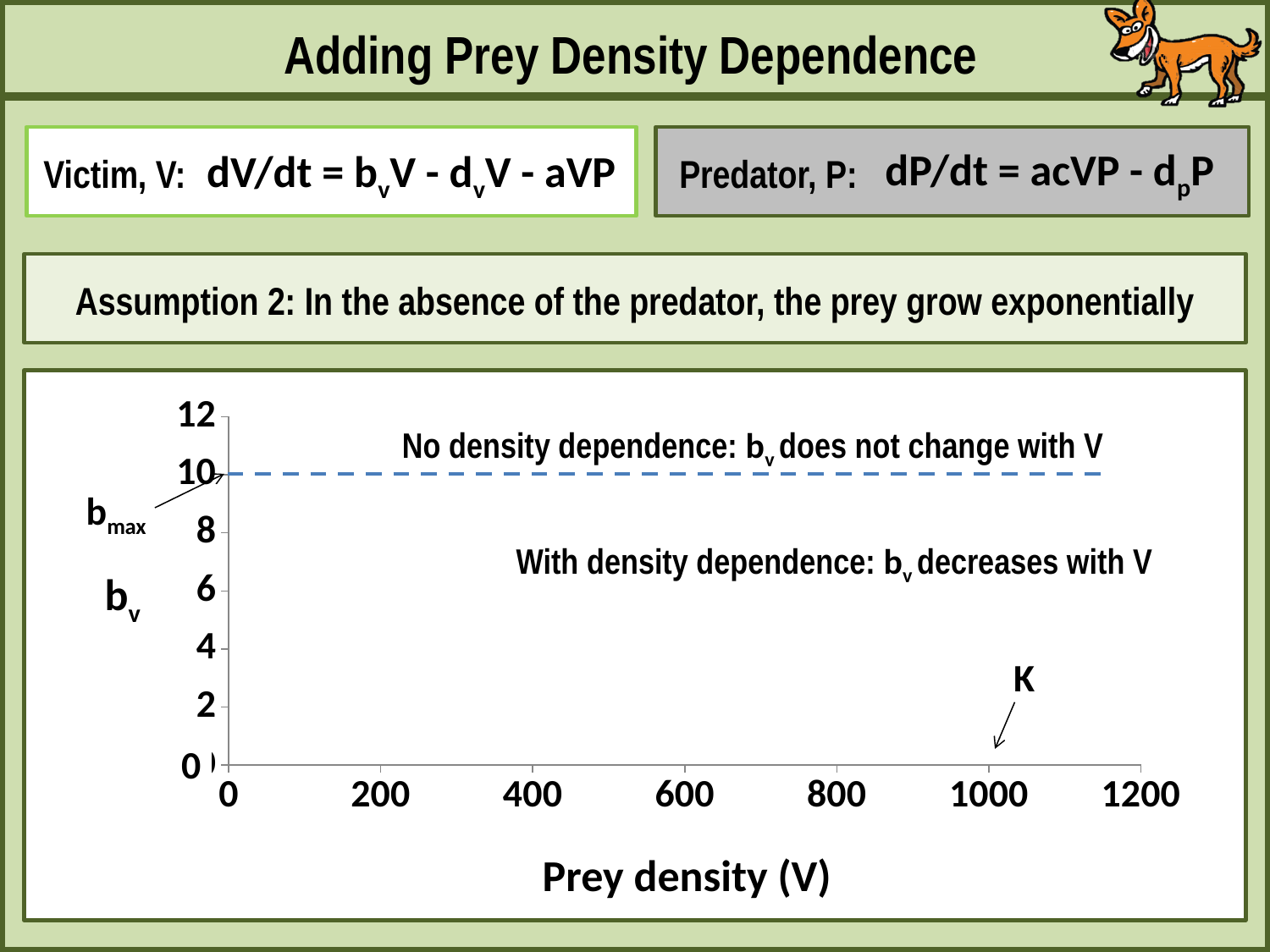
Is the value of the dashed line greater or less than 8? greater What value on the y axis does the label bmax point to? 10 What is the highest value shown on the y axis? 12 How many tick labels are shown on the x axis? 7 What is the title of the x axis of the chart? Prey density (V) Does the dashed line rise, fall or stay flat as prey density (V) increases? stays flat At what value of bv is the dashed horizontal line drawn? 10 What is the highest value shown on the x axis? 1200 Is the value of the dashed line greater or less than 12? less What does the dashed horizontal line in the chart represent? No density dependence: bv does not change with V What prey density (V) does the label K point to on the x axis? 1000 What kind of chart is shown on the slide? line chart